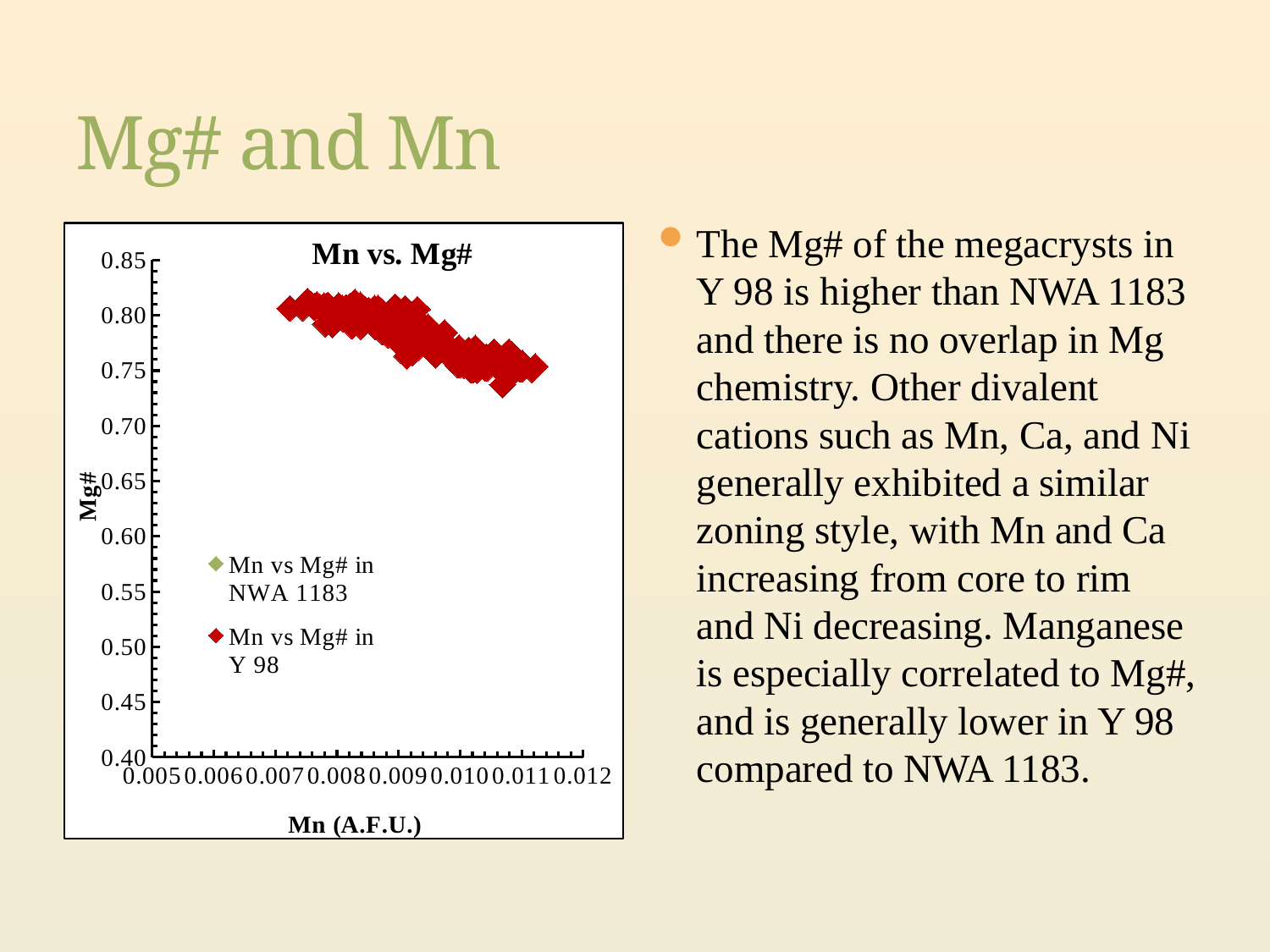
Are the Mn values for the Y 98 series greater or less than 0.006? greater What is the label of the x axis of the chart? Mn (A.F.U.) What is the title of the chart? Mn vs. Mg# Which series is plotted with red diamond markers? Mn vs Mg# in Y 98 What kind of chart is shown on the slide? scatter chart Are the Mg# values for the Y 98 series greater or less than 0.70? greater Are the Mg# values for the Y 98 series greater or less than 0.85? less As Mn increases along the x axis, do the Mg# values for Y 98 rise or fall? fall How many series does the chart's legend list? 2